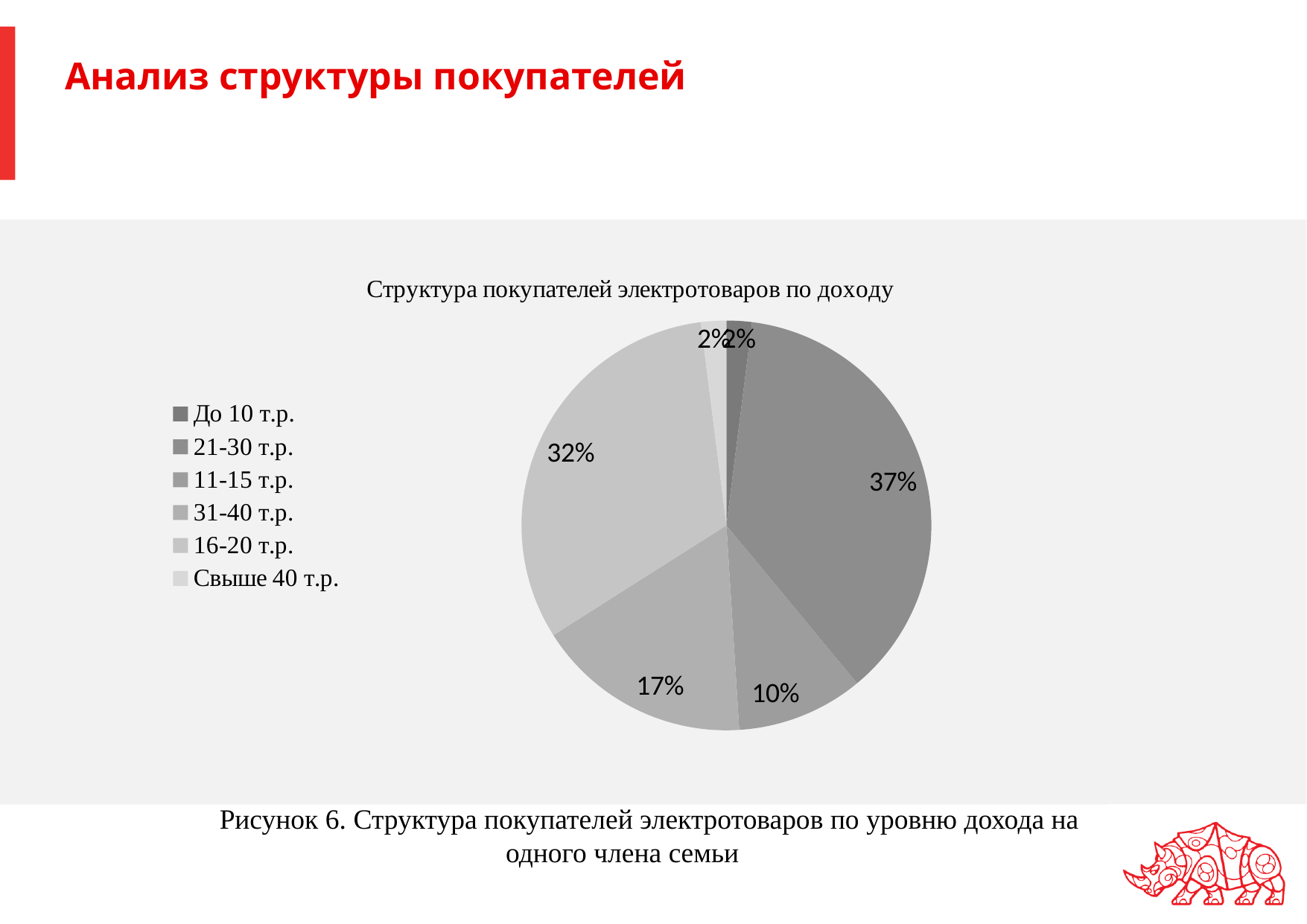
What is the share for the Свыше 40 т.р. category? 2% What share of the pie does the largest slice represent? 37% What is the difference between the 21-30 т.р. share and the 16-20 т.р. share? 5% Which income category has the largest share of buyers? 21-30 т.р. What is the share for the 16-20 т.р. category? 32% What is the title of the chart? Структура покупателей электротоваров по доходу What is the share for the 31-40 т.р. category? 17% How many categories does the legend of the pie chart list? 6 What is the share for the До 10 т.р. category? 2% What is the share for the 11-15 т.р. category? 10% Which is larger, the share for 31-40 т.р. or the share for 11-15 т.р.? 31-40 т.р. What kind of chart is shown on the slide? pie chart